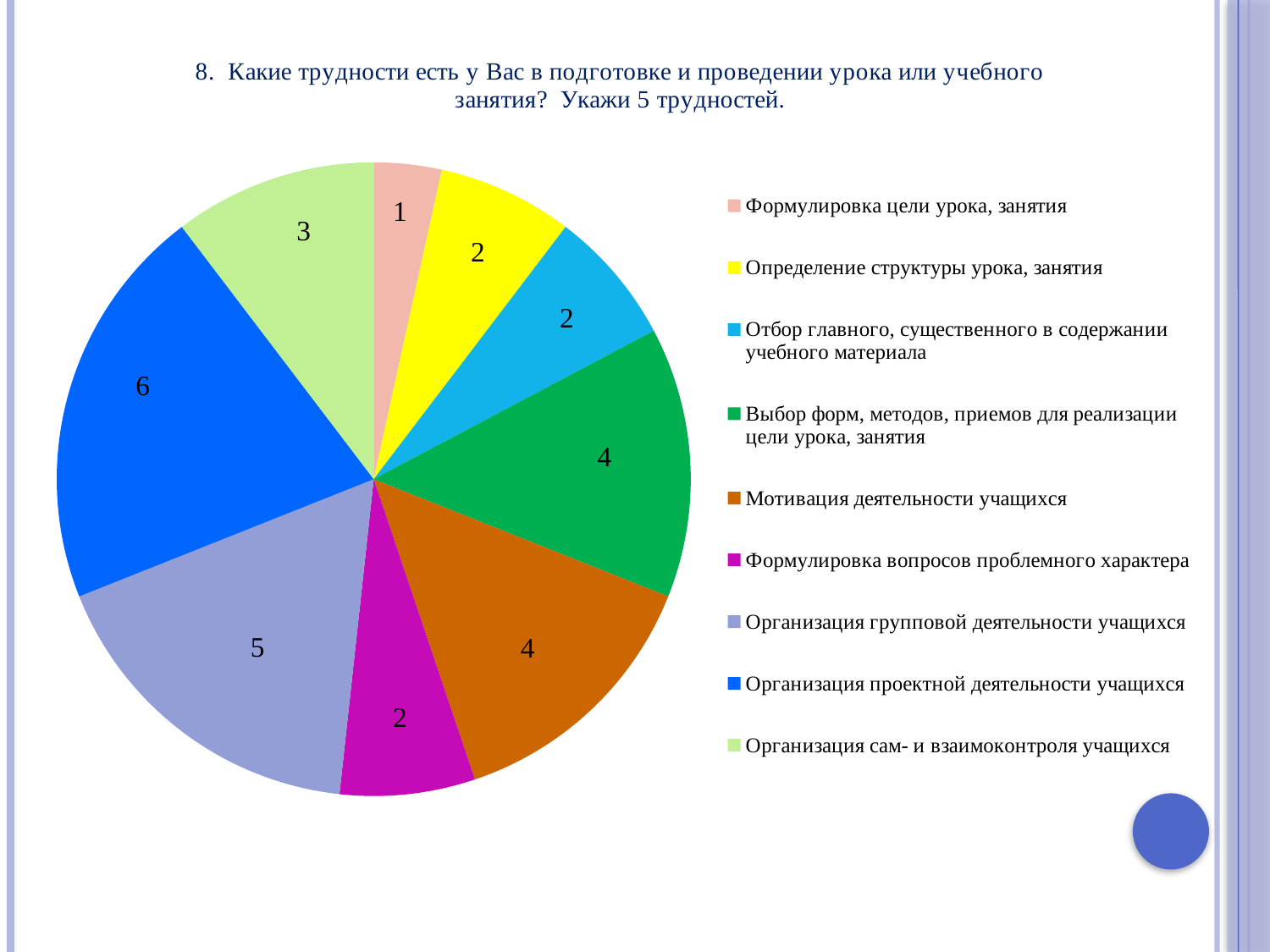
What is the value for 'Организация групповой деятельности учащихся'? 5 Which category has the largest slice of the pie? Организация проектной деятельности учащихся Which category has the smallest slice of the pie? Формулировка цели урока, занятия What is the value for 'Организация сам- и взаимоконтроля учащихся'? 3 How many slices does the pie chart have? 9 What is the value for 'Организация проектной деятельности учащихся'? 6 Which is larger: the value for 'Мотивация деятельности учащихся' or the value for 'Формулировка вопросов проблемного характера'? Мотивация деятельности учащихся What is the value for 'Формулировка цели урока, занятия'? 1 What colour is the slice for 'Выбор форм, методов, приемов для реализации цели урока, занятия'? green What is the difference between the values for 'Организация проектной деятельности учащихся' and 'Организация сам- и взаимоконтроля учащихся'? 3 What is the total of all the values shown in the pie chart? 29 What type of chart is shown on the slide? pie chart